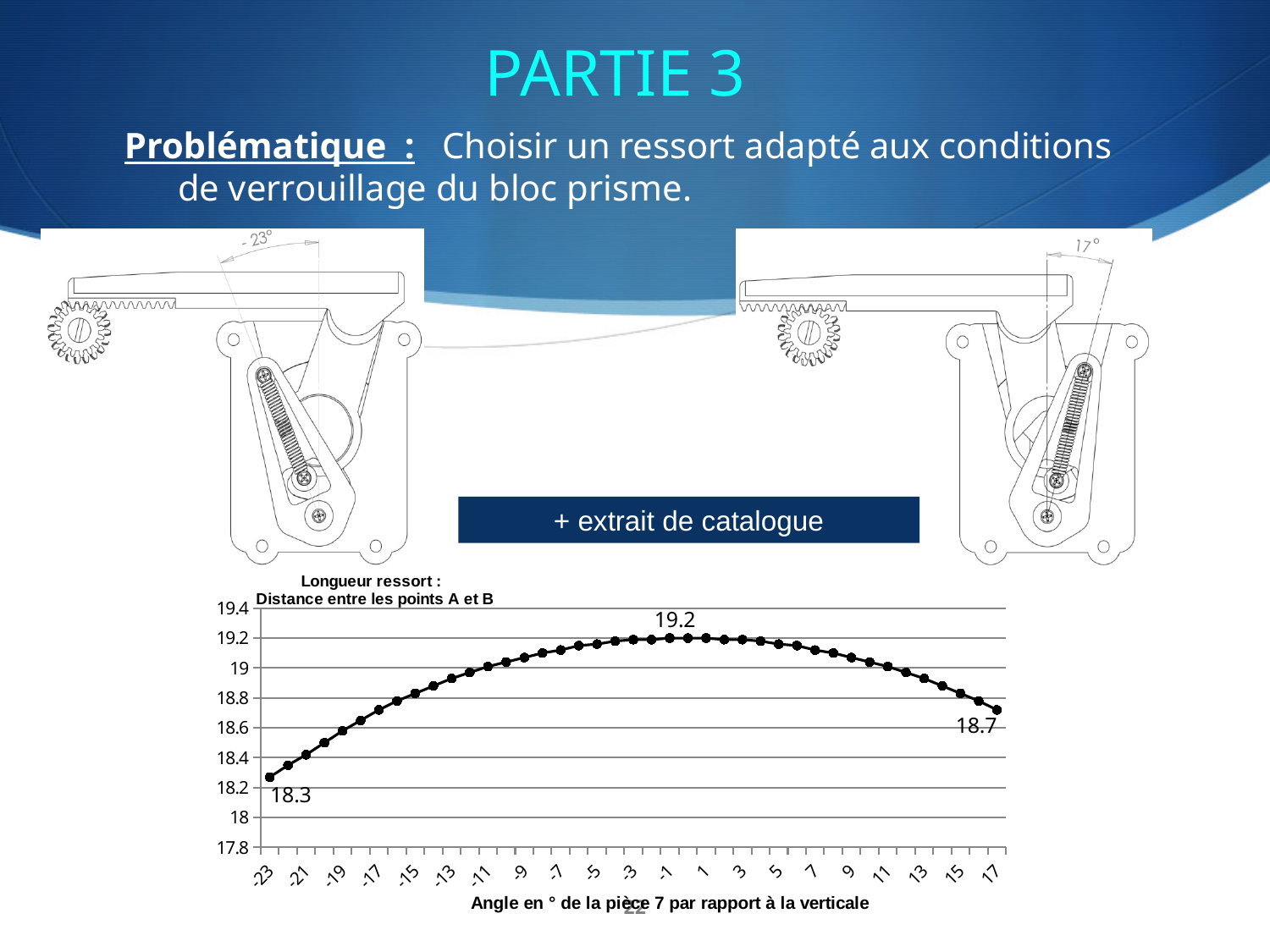
What is the title of the x axis of the chart? Angle en ° de la pièce 7 par rapport à la verticale What kind of chart is shown on the slide? line chart Is the value at -19° greater or less than 18.8? less Is the value at -5° greater or less than 19? greater What is the spring length (distance between points A and B) at an angle of -23°? 18.3 What is the maximum value labelled on the curve? 19.2 What is the difference between the maximum labelled value (19.2) and the value at -23°? 0.9 Which is larger, the spring length at -23° or at 17°? 17° What is the spring length at an angle of 17°? 18.7 At which angle is the spring length lowest? -23 What is the difference between the value at 17° and the value at -23°? 0.4 Does the spring length rise or fall as the angle goes from -23° to -1°? rise